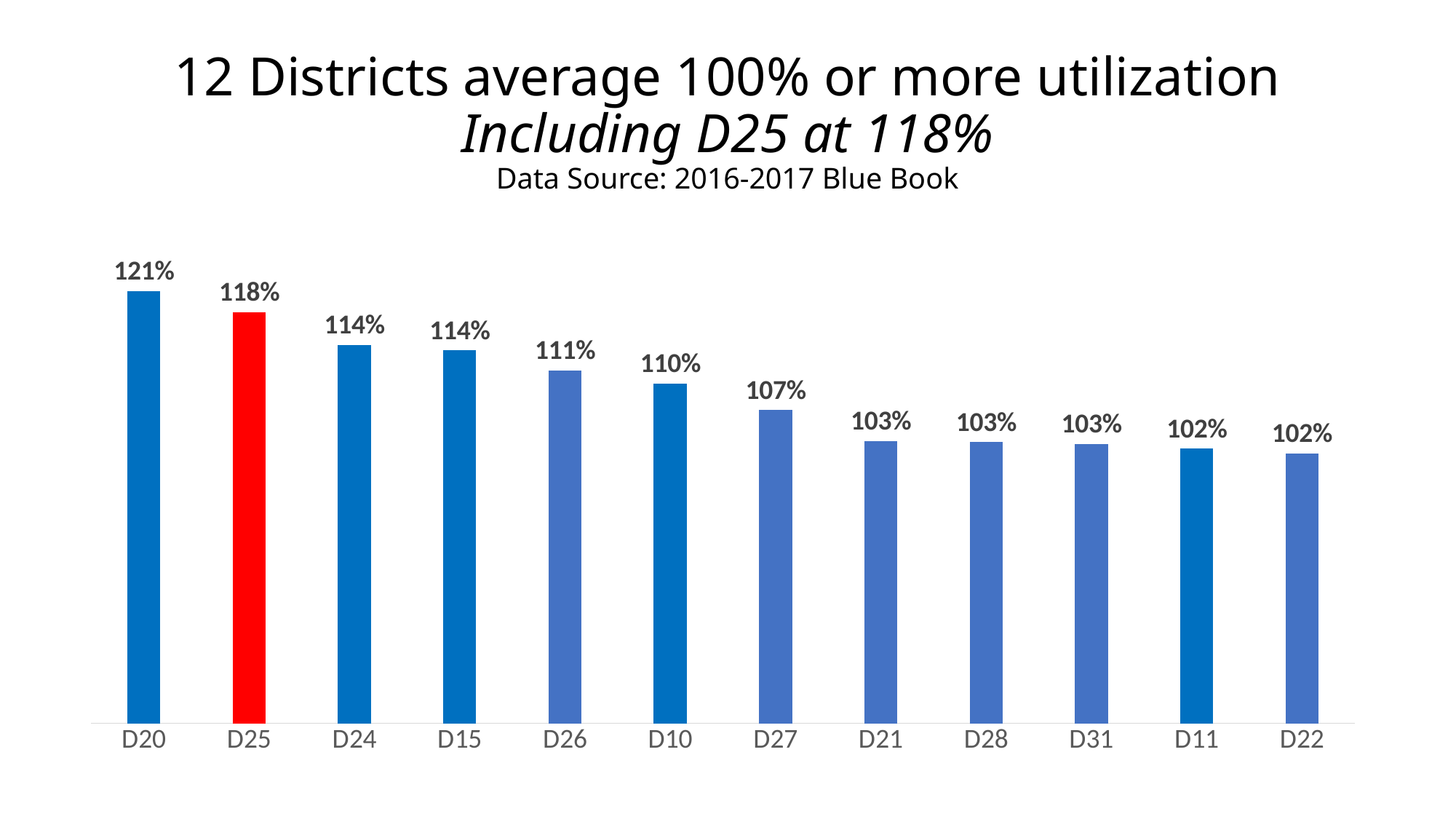
What is the utilization value for D27? 107% What kind of chart is shown on the slide? Bar chart Which district's bar is coloured red? D25 What is the utilization value for D25? 118% What is the difference between the utilization of D26 and D22? 9% What is the difference between the utilization of D20 and D25? 3% How many districts are shown in the chart? 12 Which district has the highest utilization? D20 Which has a higher utilization, D24 or D21? D24 Do the values rise or fall from left to right across the chart? Fall Which has a higher utilization, D27 or D26? D26 What is the utilization value for D10? 110%